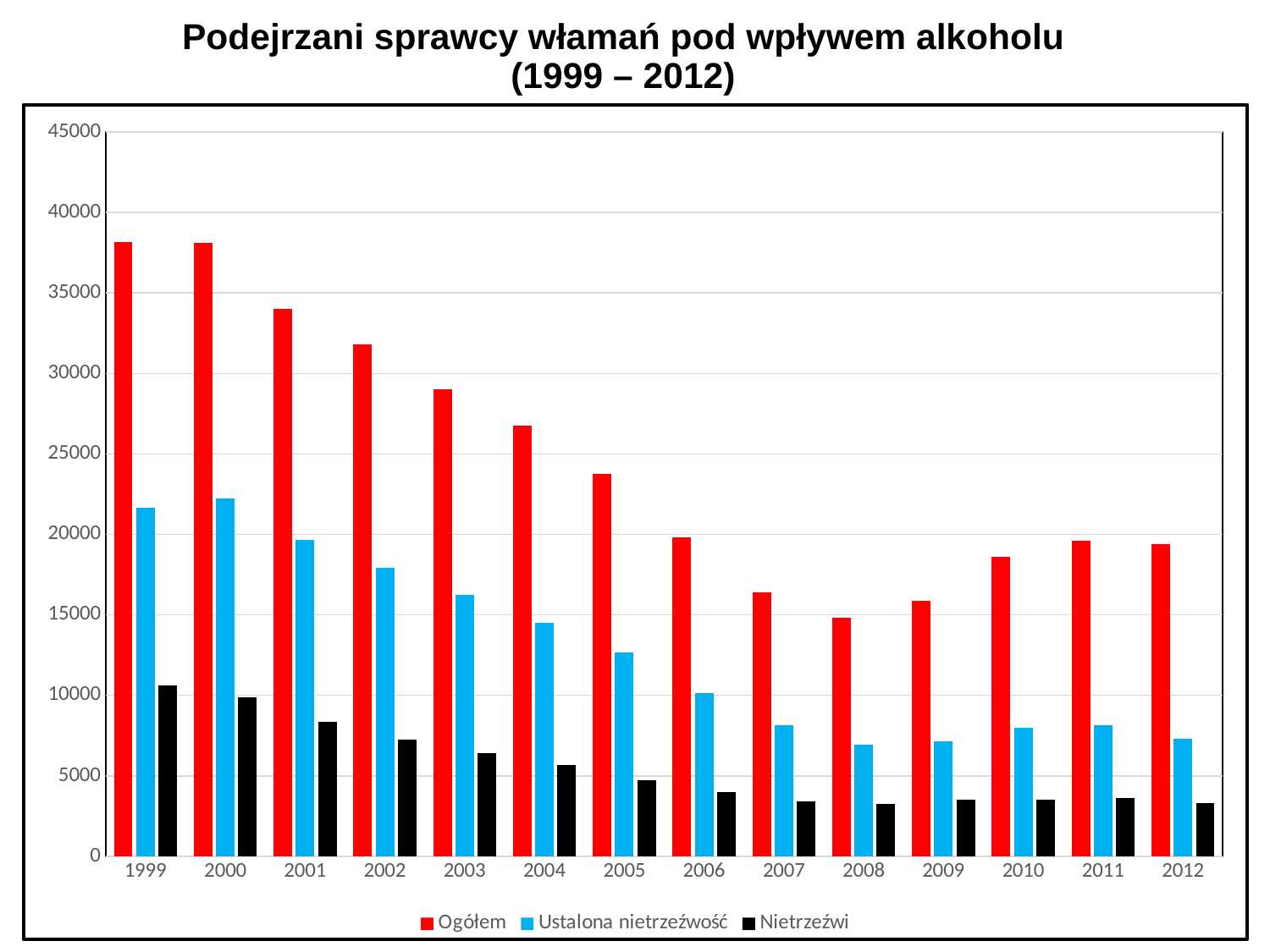
Is the Ogółem value for 1999 greater or less than 35000? greater How many years are shown on the x axis? 14 Does the Ogółem series rise or fall from 1999 to 2008? fall Is the Ustalona nietrzeźwość value for 1999 greater or less than 20000? greater Which year has the larger Ustalona nietrzeźwość value, 2005 or 2006? 2005 Which year has the larger Ogółem value, 2001 or 2002? 2001 In which year is the Ogółem value lowest? 2008 What kind of chart is shown on the slide? bar chart Is the Nietrzeźwi value for 2006 greater or less than 5000? less How many series does the legend list? 3 In which year is the Nietrzeźwi value highest? 1999